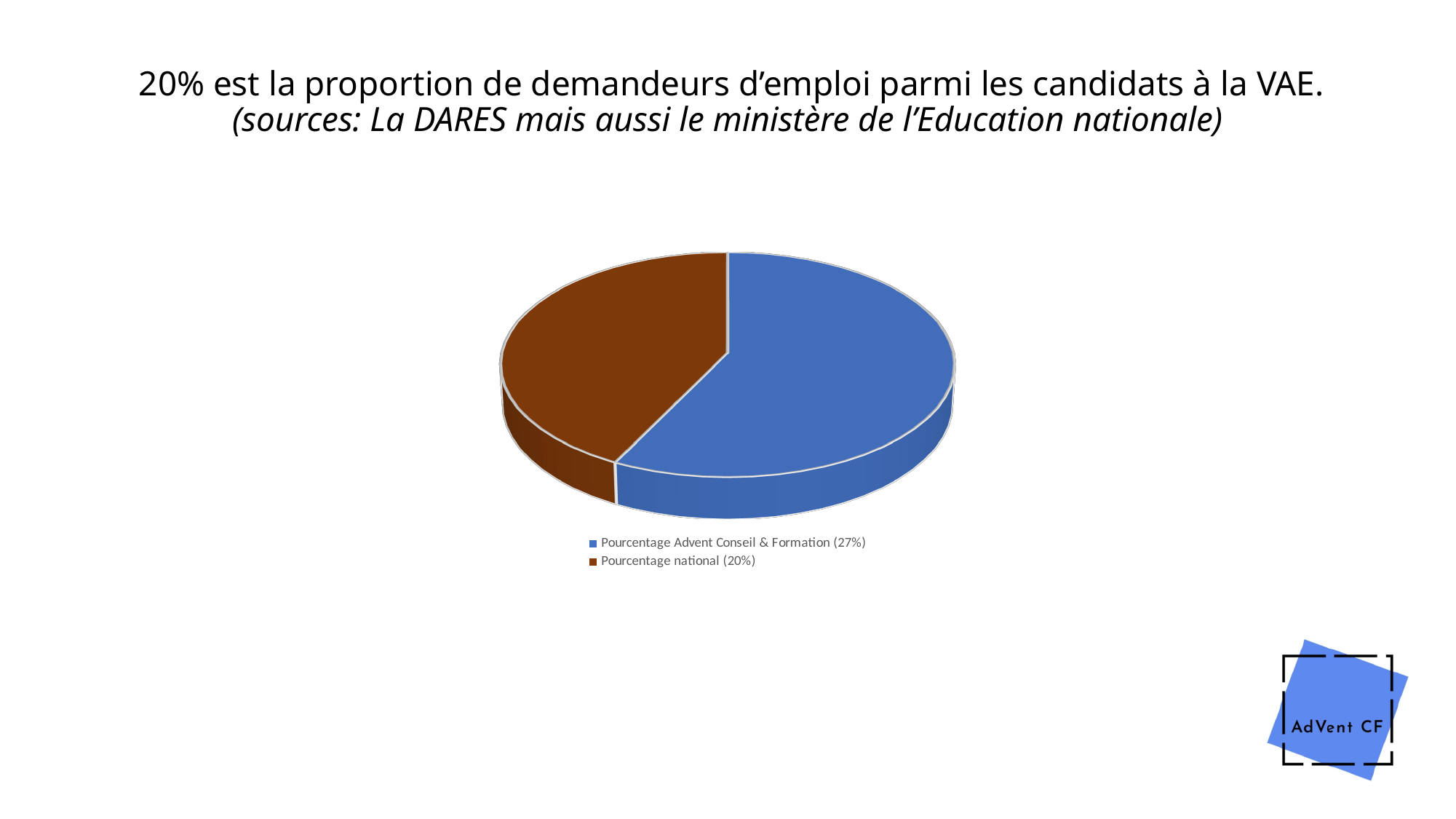
How many entries does the legend of the pie chart list? 2 What colour is the slice for Pourcentage Advent Conseil & Formation? blue How many slices does the pie chart have? 2 Which is larger, the Advent Conseil & Formation percentage or the national percentage? Advent Conseil & Formation What is the difference in percentage points between the Advent Conseil & Formation value (27%) and the national value (20%)? 7 What percentage is given in the legend for Pourcentage Advent Conseil & Formation? 27% Which slice of the pie chart is the smallest? Pourcentage national (20%) What kind of chart is shown on the slide? pie chart What percentage is given in the legend for Pourcentage national? 20% Which slice of the pie chart is the largest? Pourcentage Advent Conseil & Formation (27%) What colour is the slice for Pourcentage national? brown